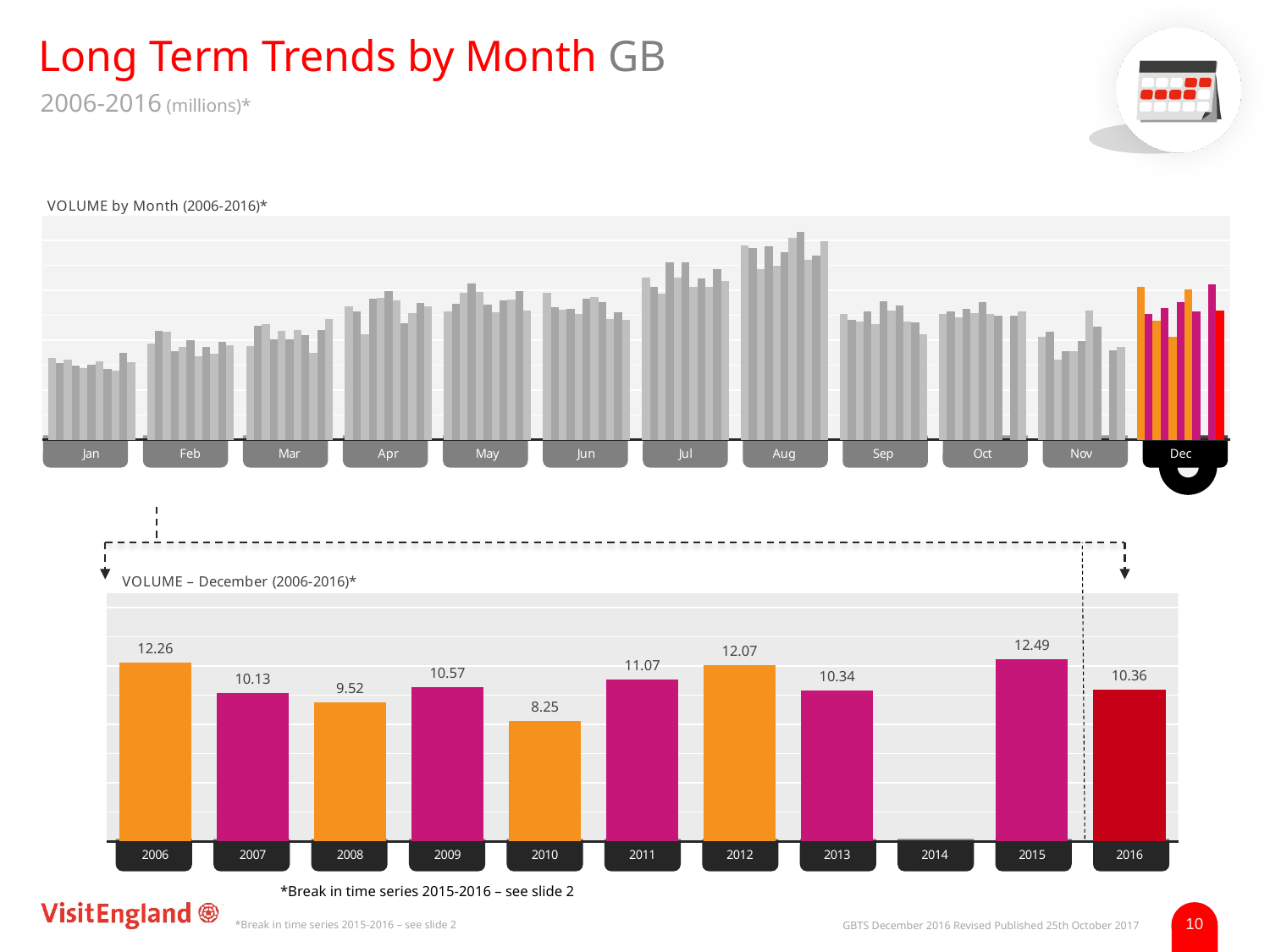
In the VOLUME – December (2006-2016) chart, what is the value for 2006? 12.26 In the VOLUME – December (2006-2016) chart, which is larger, the value for 2011 or the value for 2013? 2011 In the VOLUME – December (2006-2016) chart, which year with a plotted bar has the lowest value? 2010 In the VOLUME – December (2006-2016) chart, what is the value for 2010? 8.25 In the VOLUME – December (2006-2016) chart, what is the difference between the values for 2015 and 2016? 2.13 In the VOLUME – December (2006-2016) chart, what is the value for 2016? 10.36 How many months are shown on the x axis of the VOLUME by Month (2006-2016) chart? 12 In the VOLUME – December (2006-2016) chart, which year has the highest value? 2015 In the VOLUME by Month (2006-2016) chart, which month has the highest bars? Aug What kind of chart is the VOLUME – December (2006-2016) chart? Bar chart In the VOLUME – December (2006-2016) chart, which year has no bar plotted? 2014 In the VOLUME – December (2006-2016) chart, what is the difference between the values for 2006 and 2007? 2.13